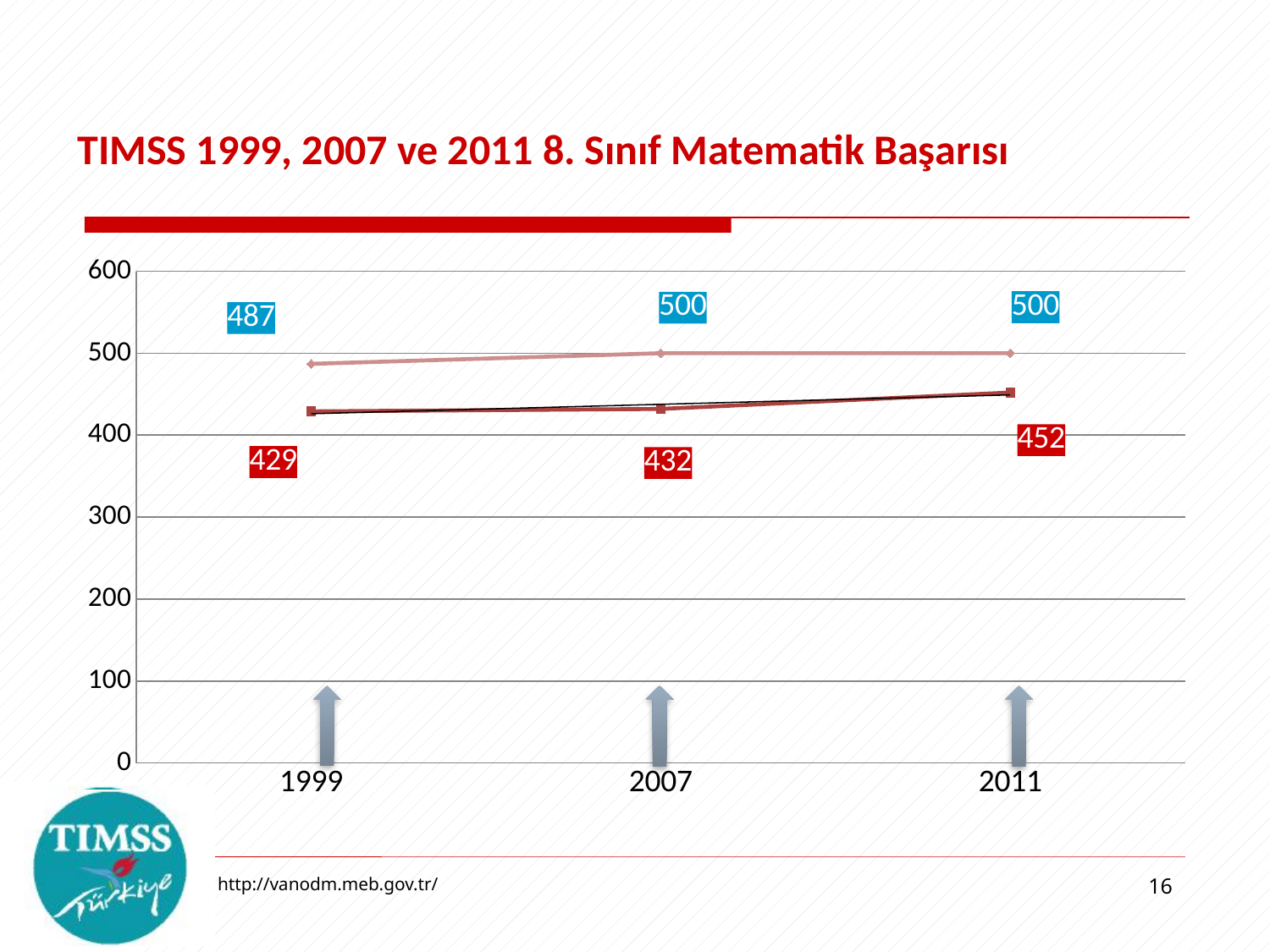
What is the value of the lower (red-labelled) line in 2011? 452 What is the title of the chart on the slide? TIMSS 1999, 2007 ve 2011 8. Sınıf Matematik Başarısı What is the value of the upper (blue-labelled) line in 2007? 500 In which year does the lower (red-labelled) line reach its highest value? 2011 What is the value of the upper (blue-labelled) line in 1999? 487 Which is larger in 1999: the upper line value or the lower line value? the upper line (487) How many years are plotted along the x axis? 3 Does the lower (red-labelled) line rise or fall from 1999 to 2011? rise What is the value of the lower (red-labelled) line in 2007? 432 What is the difference between the upper line and the lower line in 2011? 48 What kind of chart is shown on the slide? line chart What is the value of the lower (red-labelled) line in 1999? 429